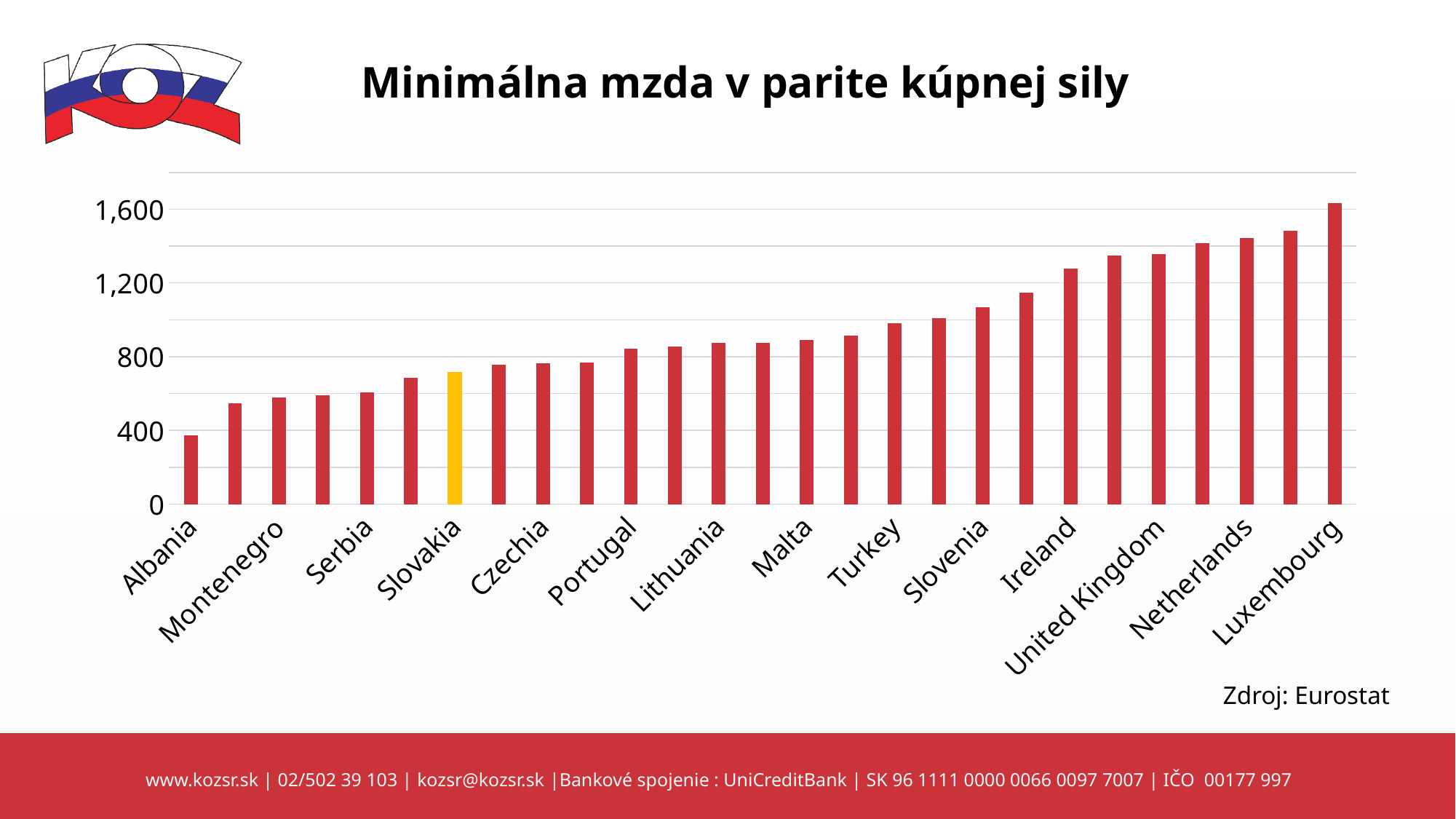
Which country has the lowest minimum wage in the chart? Albania How many bars are plotted in the chart? 27 Is the value for Luxembourg greater or less than 1,600? greater Do the values rise or fall from left to right along the x axis? rise Which is larger, the value for Slovakia or the value for Slovenia? Slovenia Is the value for Albania greater or less than 400? less Which country has the highest minimum wage in the chart? Luxembourg What kind of chart is shown on the slide? bar chart Is the value for Ireland greater or less than 1,200? greater Which country's bar is highlighted in a different colour (yellow) from the others? Slovakia